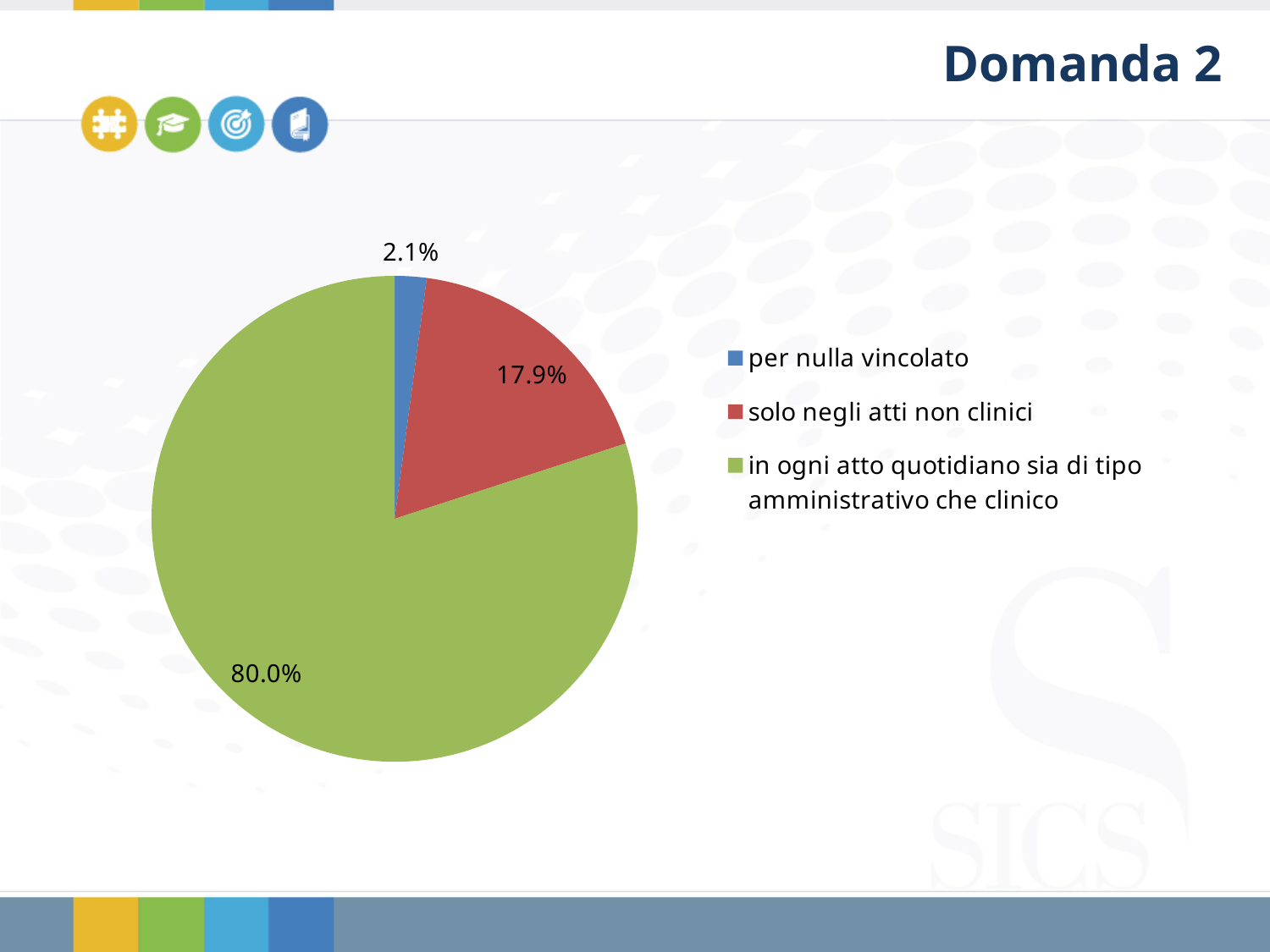
What kind of chart is shown on the slide? pie chart What is the title of the slide containing the chart? Domanda 2 Which category has the largest share of the pie? in ogni atto quotidiano sia di tipo amministrativo che clinico How many slices does the pie chart have? 3 What colour is the slice for "solo negli atti non clinici"? red Which is larger: "solo negli atti non clinici" or "per nulla vincolato"? solo negli atti non clinici What is the difference between the values for "solo negli atti non clinici" and "per nulla vincolato"? 15.8% What is the value for "solo negli atti non clinici"? 17.9% What is the value for "in ogni atto quotidiano sia di tipo amministrativo che clinico"? 80.0% Which category has the smallest share of the pie? per nulla vincolato What is the difference between the values for "in ogni atto quotidiano sia di tipo amministrativo che clinico" and "solo negli atti non clinici"? 62.1% What is the value for "per nulla vincolato"? 2.1%